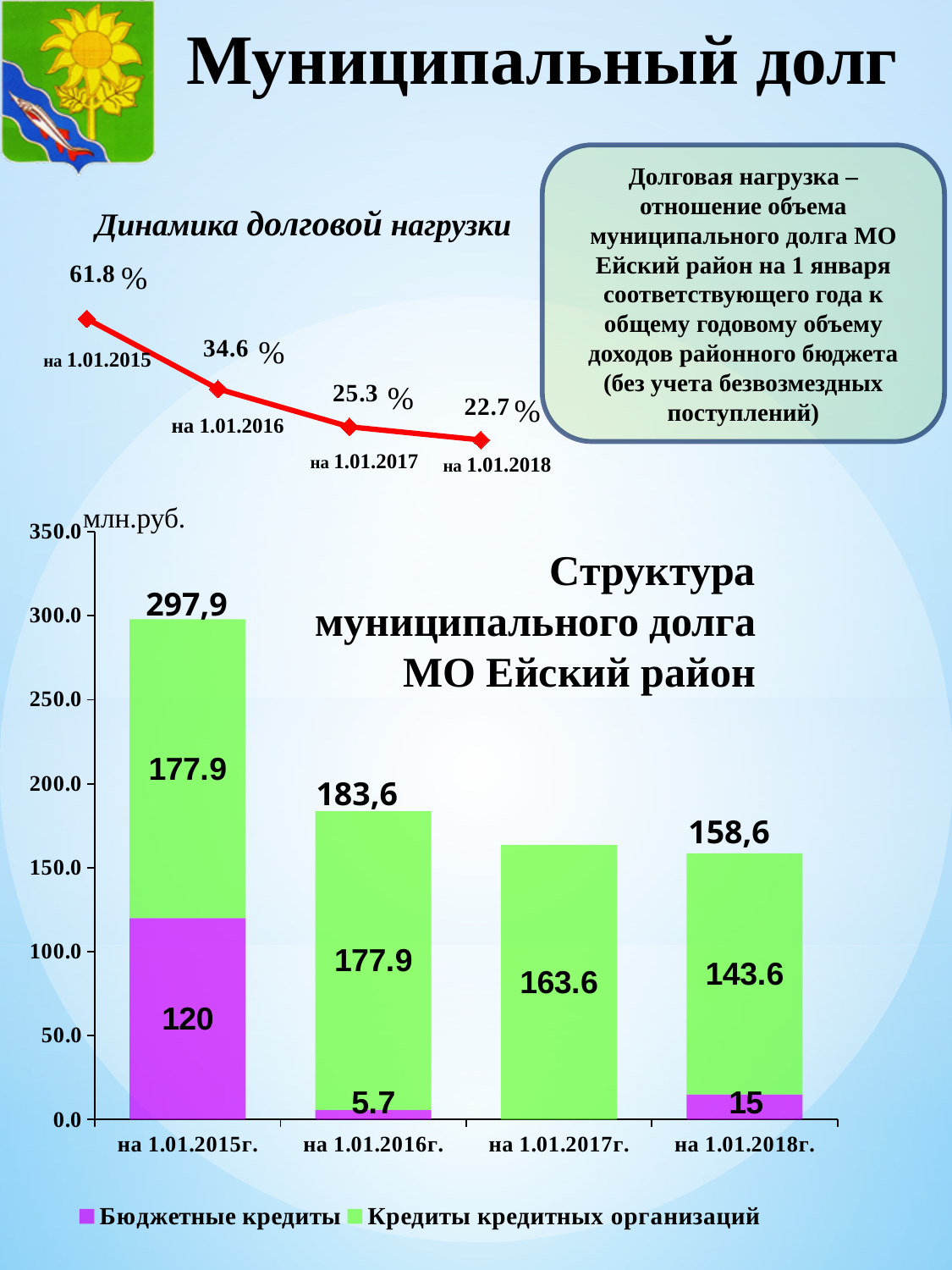
In the chart 'Динамика долговой нагрузки', what is the value for на 1.01.2015? 61.8 % In the chart 'Структура муниципального долга МО Ейский район', what is the value of Кредиты кредитных организаций for на 1.01.2018г.? 143.6 What kind of chart is 'Структура муниципального долга МО Ейский район'? stacked bar chart In the chart 'Динамика долговой нагрузки', what is the value for на 1.01.2018? 22.7 % In the chart 'Структура муниципального долга МО Ейский район', what is the value of Бюджетные кредиты for на 1.01.2015г.? 120 In the chart 'Динамика долговой нагрузки', what is the difference between the values for на 1.01.2016 and на 1.01.2017? 9.3 % In the chart 'Структура муниципального долга МО Ейский район', which is larger: Бюджетные кредиты for на 1.01.2016г. or for на 1.01.2018г.? на 1.01.2018г. In the chart 'Динамика долговой нагрузки', do the values rise or fall from 1.01.2015 to 1.01.2018? fall In the chart 'Структура муниципального долга МО Ейский район', what is the total of the stacked bar for на 1.01.2016г.? 183,6 In the chart 'Динамика долговой нагрузки', how many data points are plotted? 4 In the chart 'Структура муниципального долга МО Ейский район', which date has the highest total municipal debt? на 1.01.2015г. In the chart 'Структура муниципального долга МО Ейский район', how many series does the legend list? 2